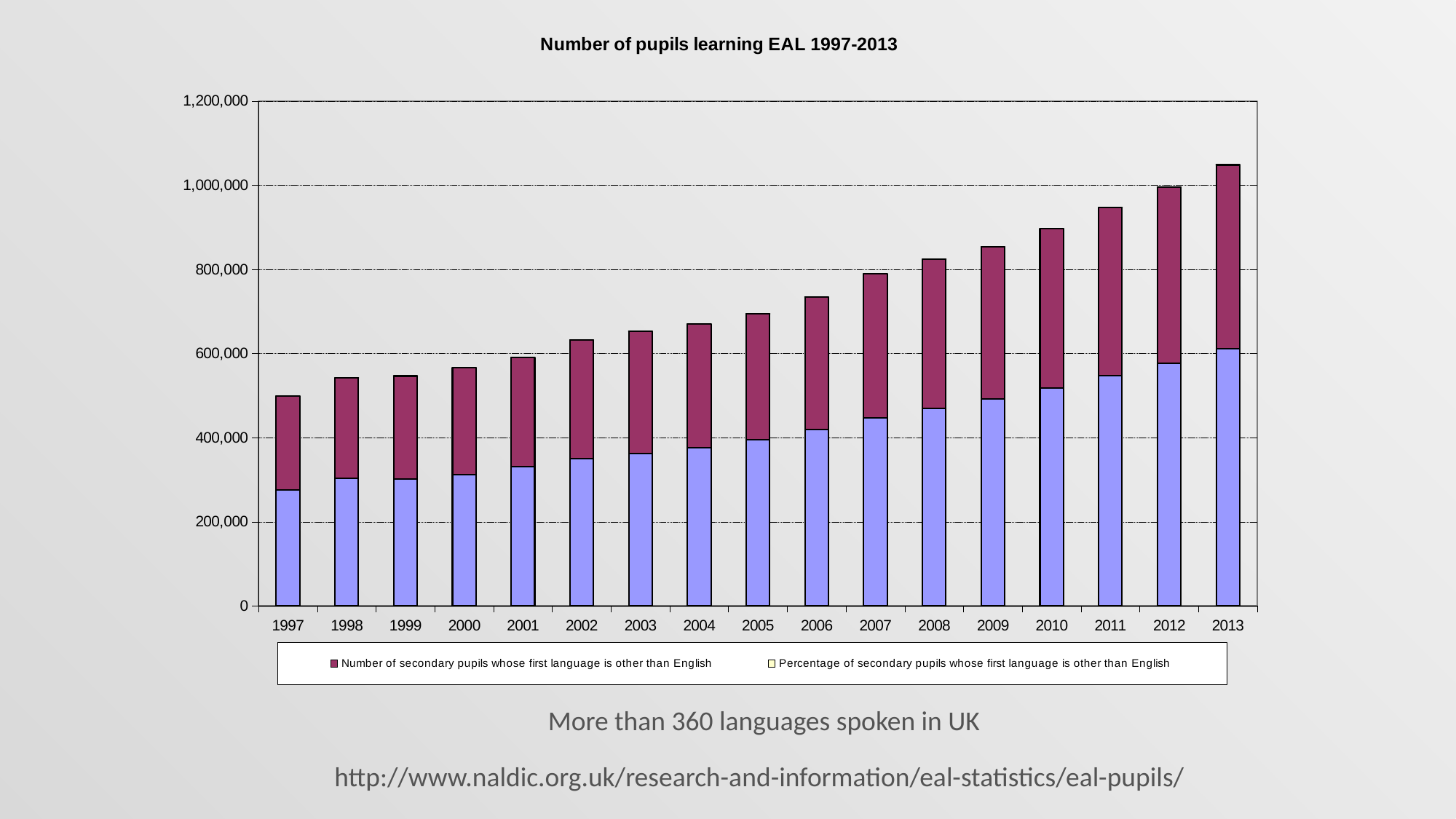
What is the title of the chart? Number of pupils learning EAL 1997-2013 Is the total bar height for 1997 greater or less than 600,000? less Which year has the tallest bar in the chart? 2013 Is the total bar height for 2010 greater or less than 800,000? greater Is the total bar height for 2013 greater or less than 1,000,000? greater What kind of chart is shown on the slide? Stacked bar chart Do the total bar heights rise or fall from 1997 to 2013? Rise Which year has the shortest bar in the chart? 1997 How many series does the chart's legend list? 2 Which year has a taller total bar, 2005 or 2009? 2009 How many years are shown along the x axis of the chart? 17